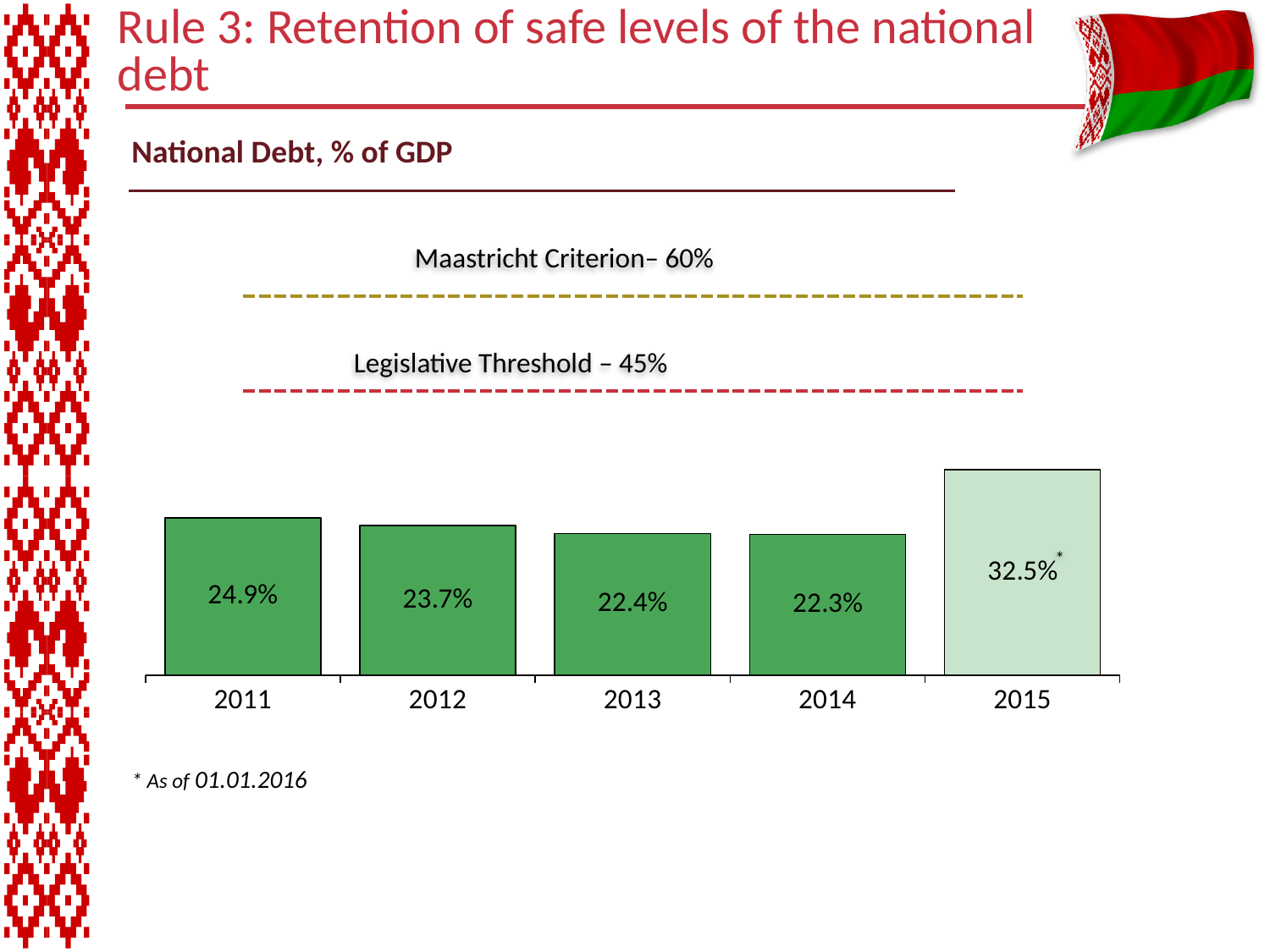
What is the difference in national debt (% of GDP) between 2015 and 2014? 10.2 percentage points What is the national debt as a percentage of GDP for 2013? 22.4% What is the difference in national debt (% of GDP) between 2011 and 2012? 1.2 percentage points Which year has a larger national debt as a percentage of GDP, 2011 or 2013? 2011 What is the national debt as a percentage of GDP for 2015? 32.5% How many years are shown on the chart? 5 Is the 2015 national debt value greater or less than the Legislative Threshold of 45%? less Which year has the highest national debt as a percentage of GDP? 2015 What is the national debt as a percentage of GDP for 2011? 24.9% What is the Maastricht Criterion level shown on the chart? 60% Which year has the lowest national debt as a percentage of GDP? 2014 What kind of chart is shown on the slide? Bar chart